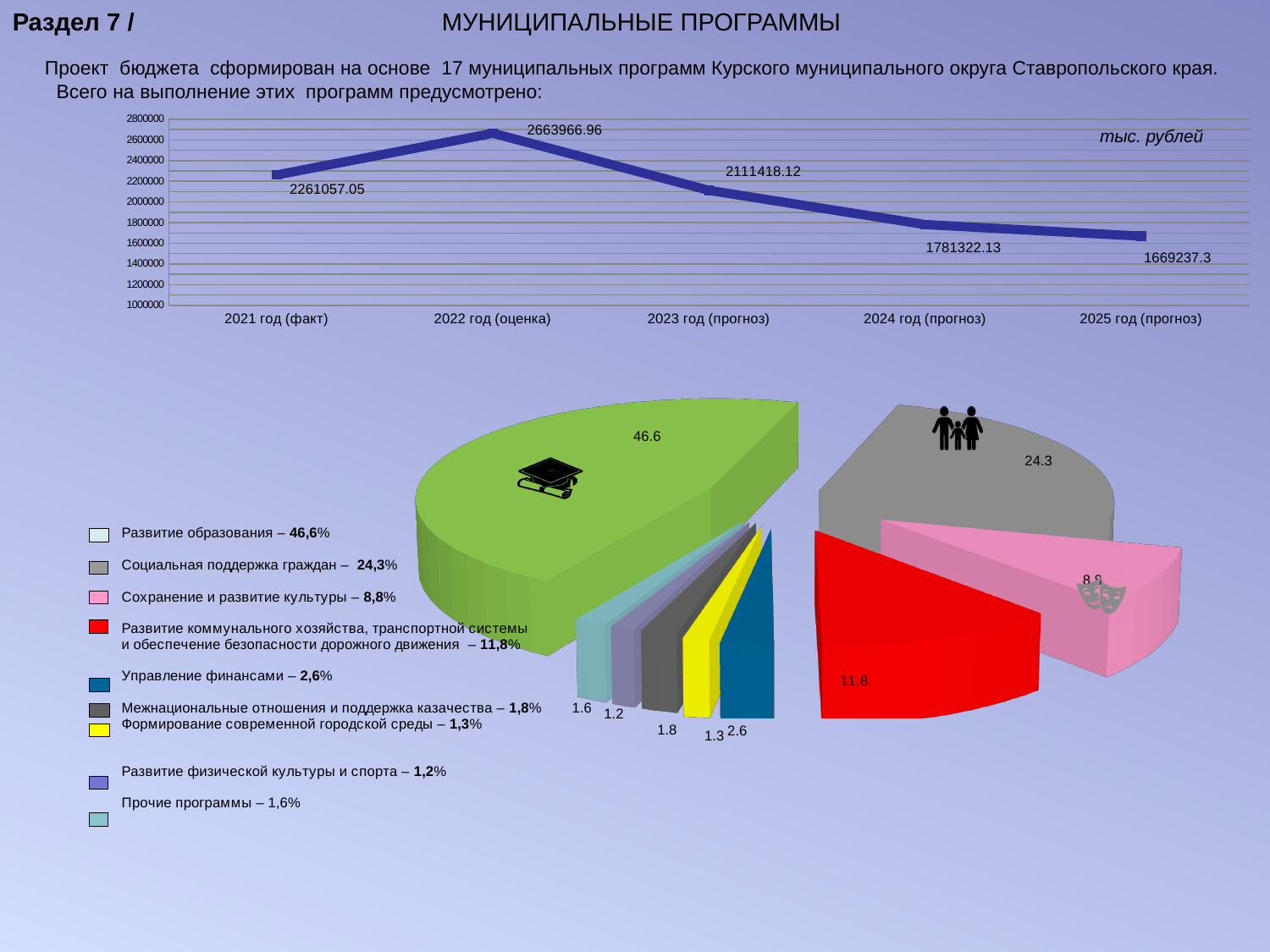
On the top line chart, how many data points are plotted? 5 On the top line chart, which year has the lowest value? 2025 год (прогноз) On the bottom pie chart, which is larger: the red slice labelled 11.8 or the grey slice labelled 24.3? 24.3 On the top line chart, do the values rise or fall from 2022 год (оценка) to 2025 год (прогноз)? fall On the top line chart, which year has the highest value? 2022 год (оценка) On the top line chart, what is the value for 2025 год (прогноз)? 1669237.3 On the top line chart, what is the value for 2022 год (оценка)? 2663966.96 On the top line chart, what is the value for 2021 год (факт)? 2261057.05 What kind of chart is the top chart on the slide? line chart On the bottom pie chart, what is the value shown on the largest slice? 46.6 On the top line chart, what is the difference between the values for 2023 год (прогноз) and 2024 год (прогноз)? 330095.99 What kind of chart is the bottom chart on the slide? pie chart